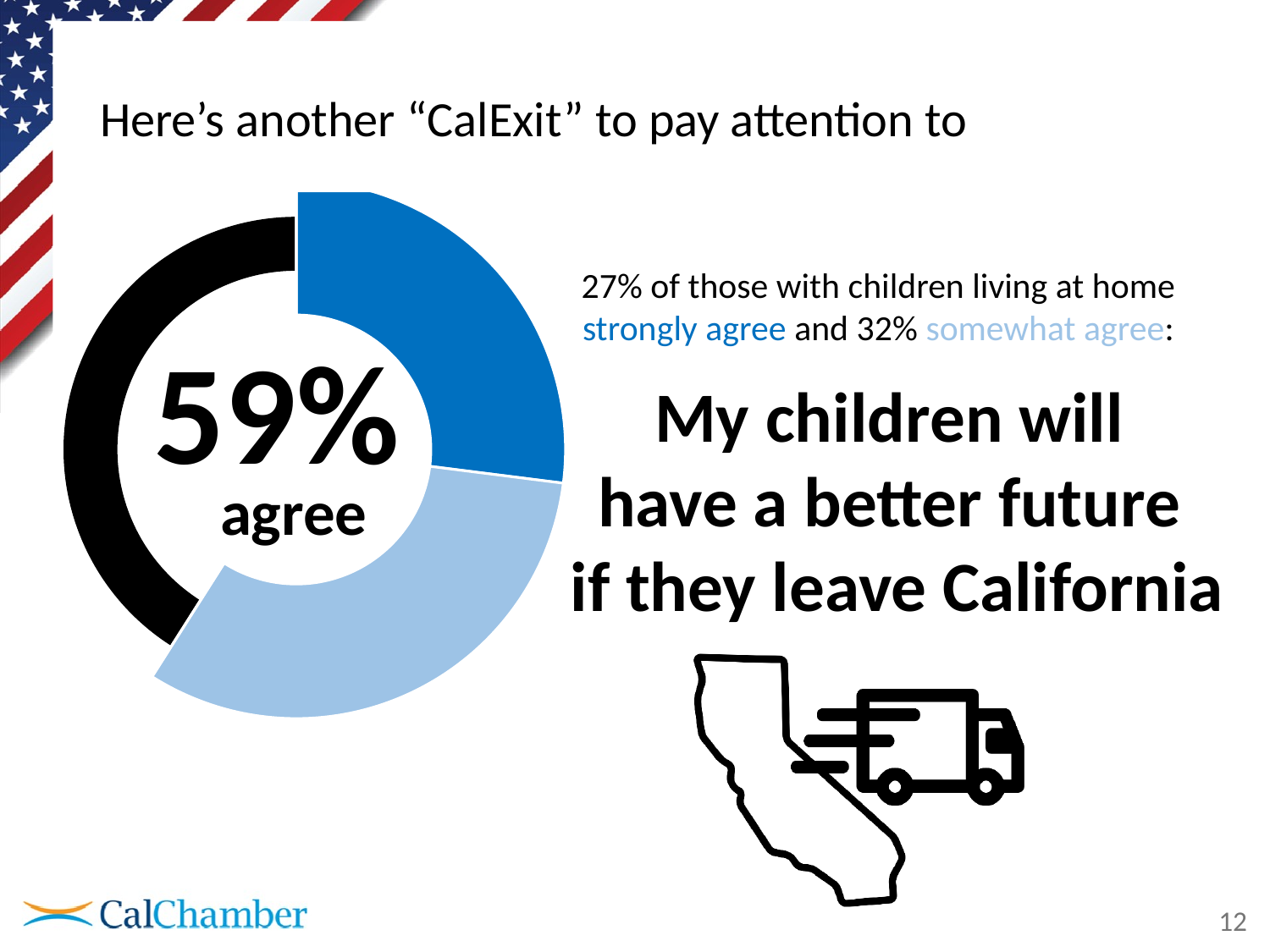
Which is larger, the share that strongly agree or the share that somewhat agree? somewhat agree What colour represents the 'strongly agree' response in the chart? dark blue Which segment is larger, the black segment or the dark blue (strongly agree) segment? black segment What kind of chart is shown on the slide? pie chart (donut) What percentage of those with children living at home somewhat agree? 32% What is the title of the slide? Here's another "CalExit" to pay attention to What is the difference between the somewhat agree share and the strongly agree share? 5% How many segments does the donut chart have? 3 What is the combined share of strongly agree and somewhat agree? 59% What value is printed in the centre of the donut chart? 59% agree What percentage of those with children living at home strongly agree that their children will have a better future if they leave California? 27%